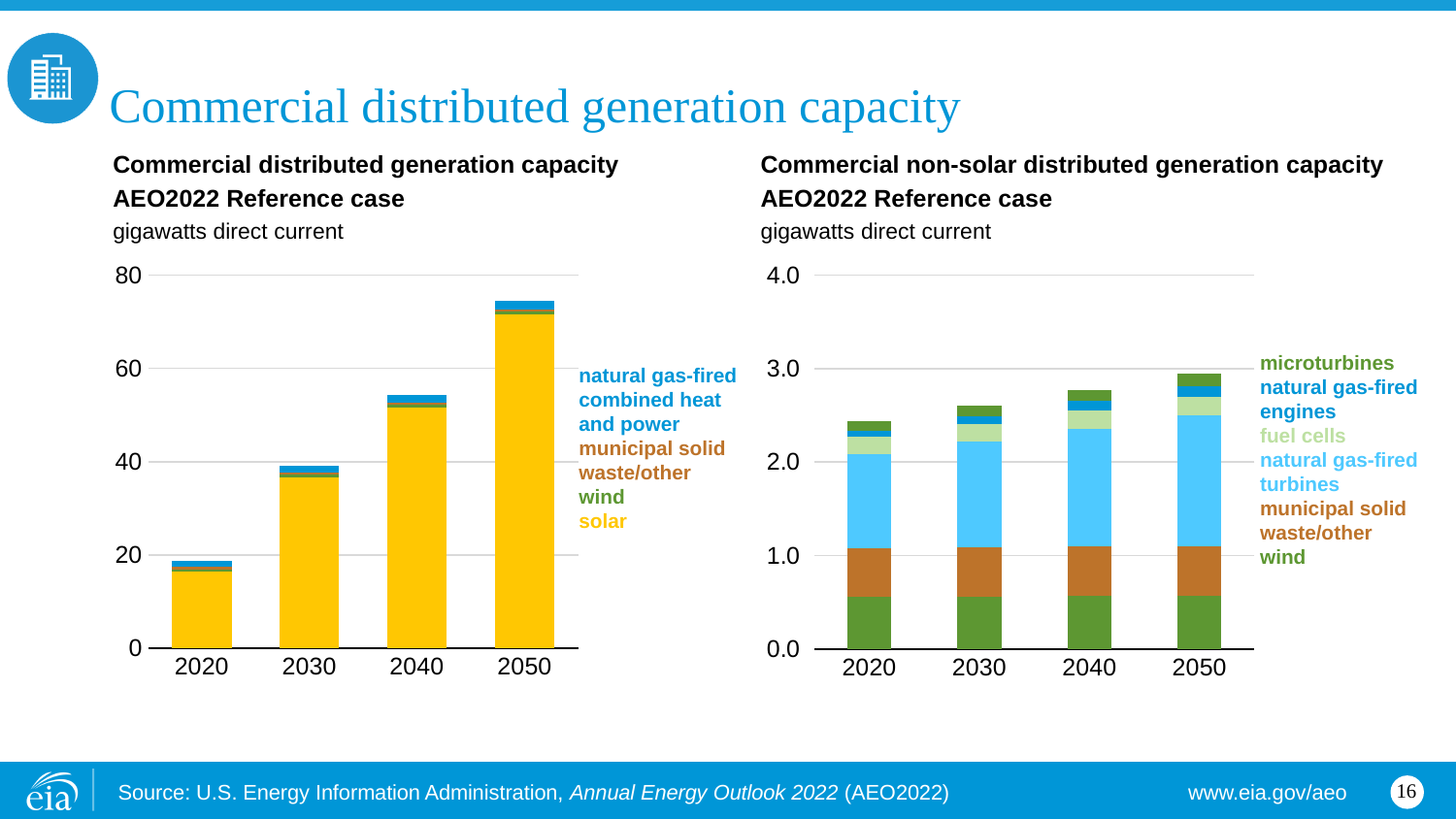
What kind of chart is the left chart, 'Commercial distributed generation capacity'? stacked bar chart How many series does the legend of the right chart, 'Commercial non-solar distributed generation capacity', list? 6 In the right chart, 'Commercial non-solar distributed generation capacity', is the total for 2020 greater or less than 2.0? greater In the right chart, 'Commercial non-solar distributed generation capacity', is the total for 2040 greater or less than 3.0? less What unit is used on the y axis of both charts? gigawatts direct current In the left chart, 'Commercial distributed generation capacity', is the total for 2050 greater or less than 60? greater How many series does the legend of the left chart, 'Commercial distributed generation capacity', list? 4 How many years are shown on the x axis of the left chart, 'Commercial distributed generation capacity'? 4 In the left chart, 'Commercial distributed generation capacity', which year has the lowest total capacity? 2020 In the left chart, 'Commercial distributed generation capacity', which year has the highest total capacity? 2050 In the left chart, 'Commercial distributed generation capacity', does total capacity rise or fall from 2020 to 2050? rise